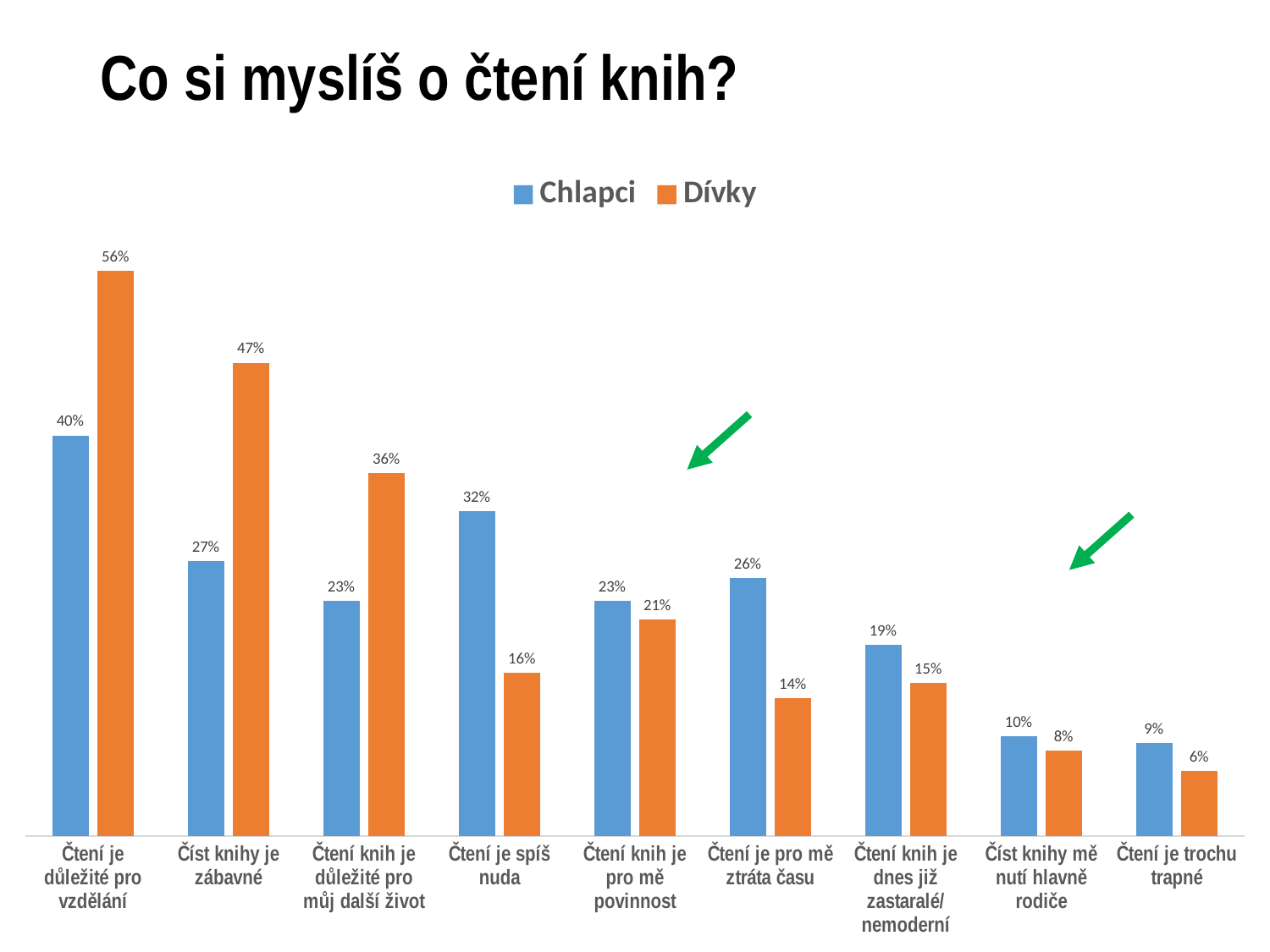
What is the value for Chlapci in the category "Čtení je spíš nuda"? 32% What is the title of the slide? Co si myslíš o čtení knih? What is the value for Dívky in the category "Čtení je pro mě ztráta času"? 14% What is the difference between Dívky and Chlapci in the category "Číst knihy je zábavné"? 20% How many categories are shown on the x axis? 9 Which category has the lowest value for Chlapci? Čtení je trochu trapné What is the value for Dívky in the category "Čtení je důležité pro vzdělání"? 56% Which colour represents the Dívky series? Orange In the category "Čtení knih je dnes již zastaralé/nemoderní", which series has the larger value, Chlapci or Dívky? Chlapci What kind of chart is shown on the slide? Bar chart How many series does the legend list? 2 Which category has the highest value for Dívky? Čtení je důležité pro vzdělání